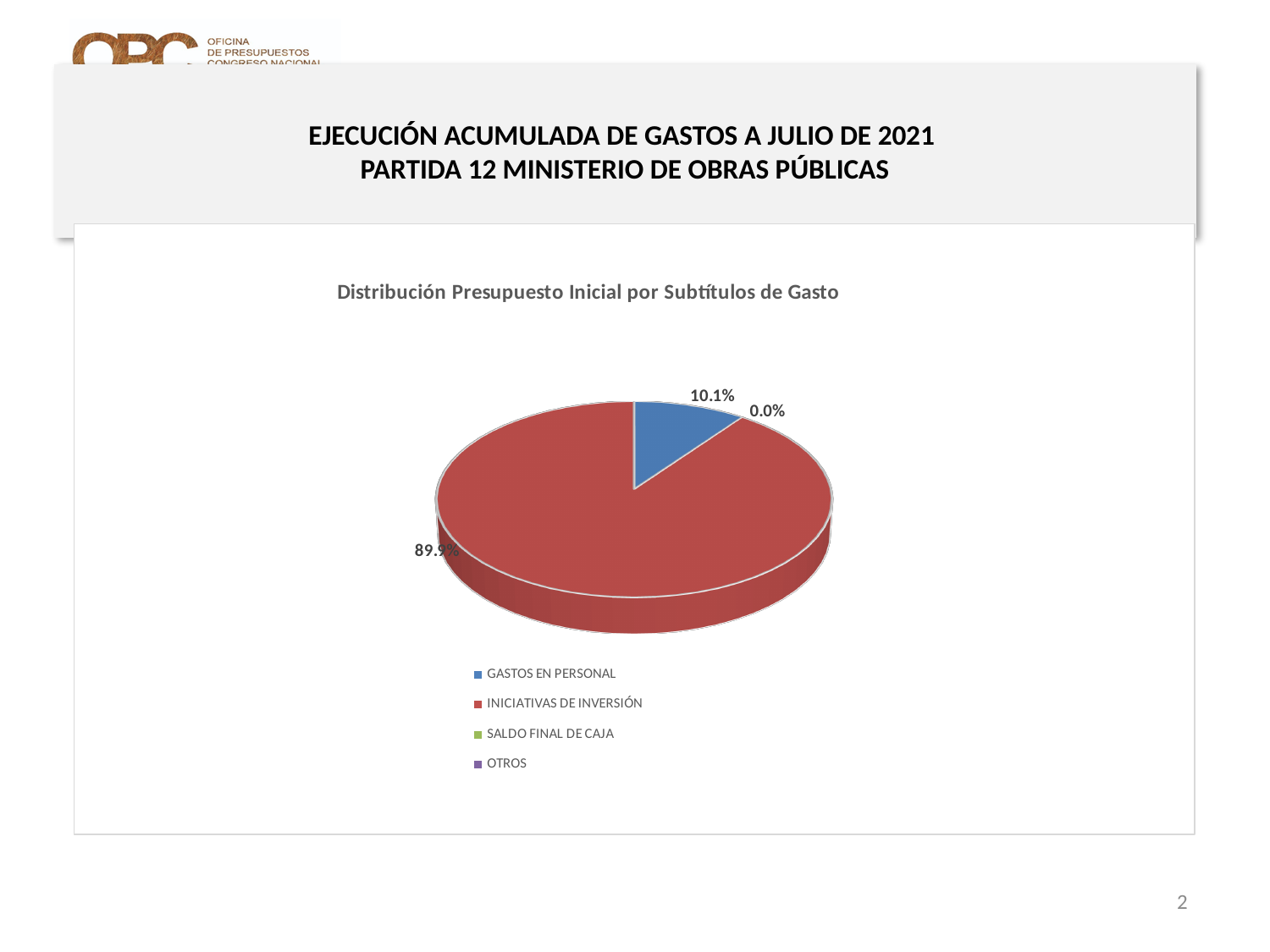
What share of the pie does INICIATIVAS DE INVERSIÓN represent? 89.9% Is the share for INICIATIVAS DE INVERSIÓN greater or less than 50%? greater What is the difference in percentage points between INICIATIVAS DE INVERSIÓN and GASTOS EN PERSONAL? 79.8 Is the share for GASTOS EN PERSONAL greater or less than 20%? less What kind of chart is shown on the slide? pie chart What is the title of the chart? Distribución Presupuesto Inicial por Subtítulos de Gasto What share of the pie does GASTOS EN PERSONAL represent? 10.1% What colour is the slice for INICIATIVAS DE INVERSIÓN? red Which is larger, the share for GASTOS EN PERSONAL or the share for INICIATIVAS DE INVERSIÓN? INICIATIVAS DE INVERSIÓN How many categories does the legend list? 4 Which category has the largest share of the pie? INICIATIVAS DE INVERSIÓN